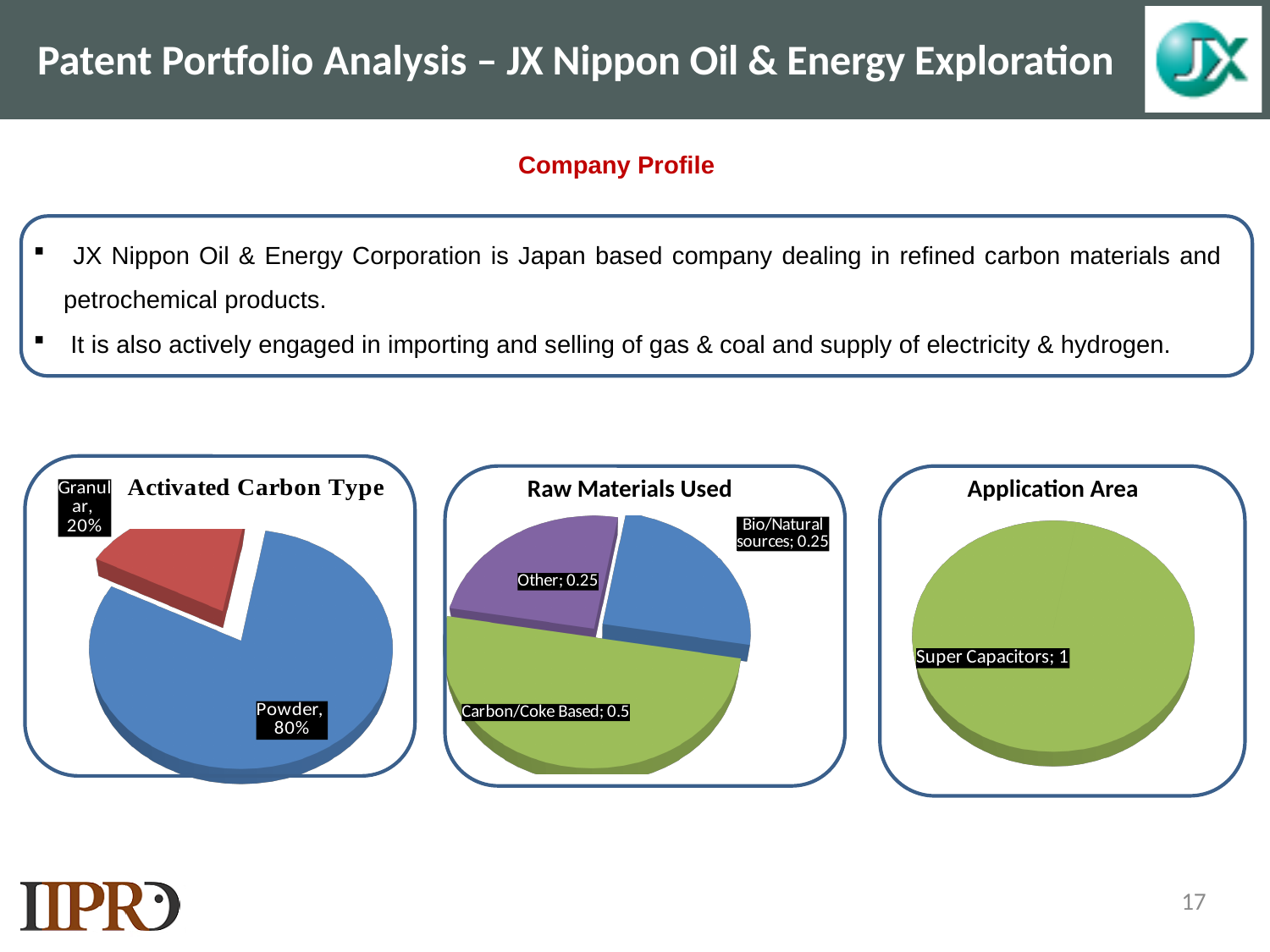
In the Raw Materials Used chart, what is the value for Bio/Natural sources? 0.25 How many categories are shown in the Application Area chart? 1 What kind of chart is the Activated Carbon Type chart? Pie chart In the Activated Carbon Type chart, what share does Granular have? 20% In the Application Area chart, what is the value for Super Capacitors? 1 In the Activated Carbon Type chart, what share does Powder have? 80% How many categories are shown in the Raw Materials Used chart? 3 In the Activated Carbon Type chart, what is the difference between the Powder and Granular shares? 60% In the Raw Materials Used chart, what is the value for Carbon/Coke Based? 0.5 In the Activated Carbon Type chart, which category has the largest slice? Powder In the Raw Materials Used chart, which is larger, Carbon/Coke Based or Other? Carbon/Coke Based In the Raw Materials Used chart, which category has the largest slice? Carbon/Coke Based